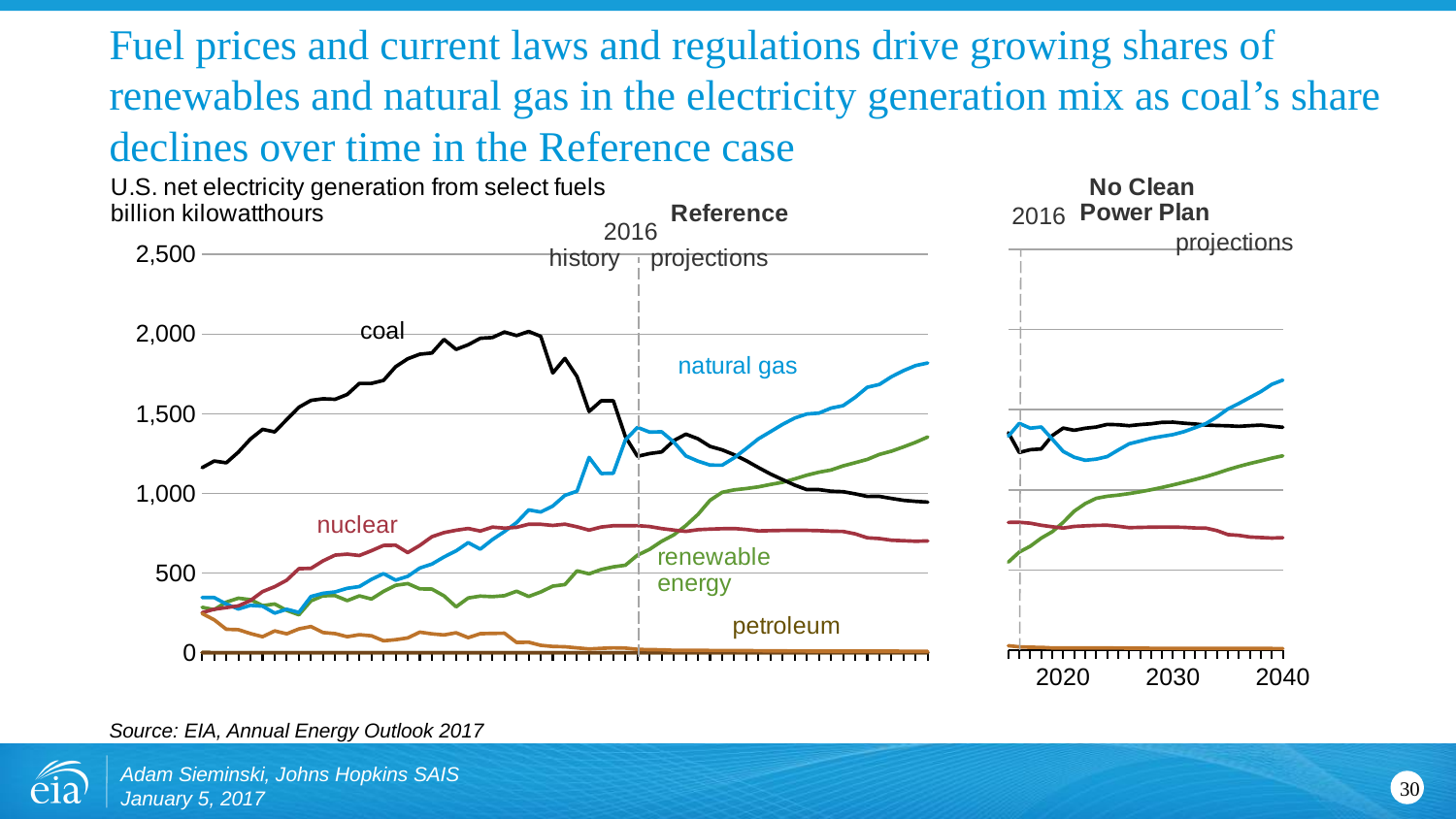
In the No Clean Power Plan chart, which is larger in 2040, coal or nuclear? coal In the No Clean Power Plan chart, is the value for coal in 2040 greater or less than 1,000? greater In the No Clean Power Plan chart, which fuel has the highest net electricity generation in 2040? natural gas In the Reference chart, does coal generation rise or fall over the projection period after 2016? fall In the Reference chart, which fuel has the lowest net electricity generation in 2040? petroleum In the Reference chart, does renewable energy generation rise or fall over the projection period after 2016? rise What unit is used on the y axis of the charts? billion kilowatthours In the Reference chart, is the value for nuclear in 2040 greater or less than 1,000? less What kind of chart is the Reference chart on the slide? line chart In the Reference chart, is the value for natural gas in 2040 greater or less than 1,500? greater How many fuel series are plotted in the Reference chart? 5 In the Reference chart, which fuel has the highest net electricity generation in 2040? natural gas